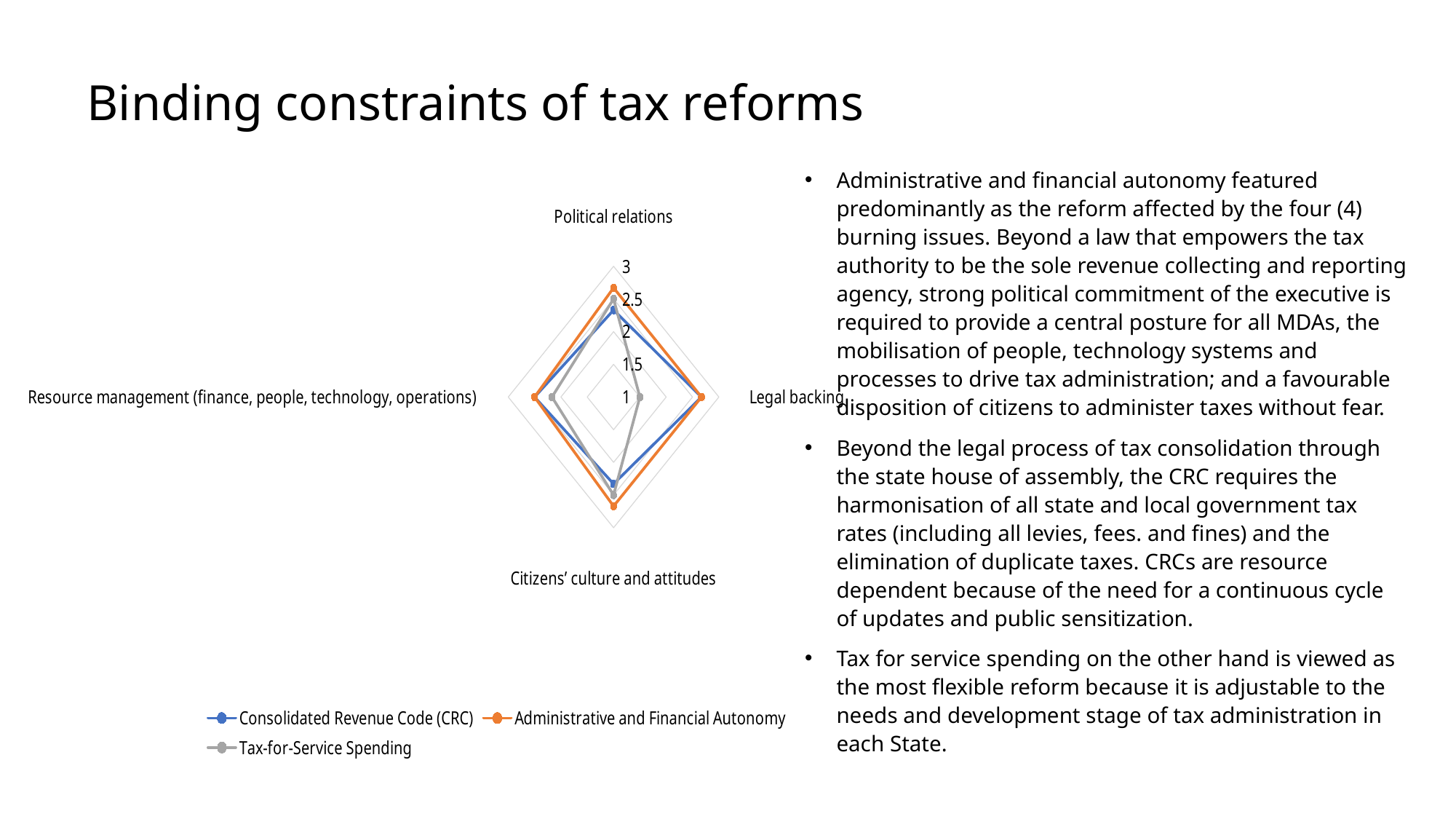
What kind of chart is shown on the slide? Radar chart How many axes (categories) does the radar chart have? 4 Is the value of Consolidated Revenue Code (CRC) on the Citizens' culture and attitudes axis greater or less than 2? greater How many series does the legend of the chart list? 3 What is the highest value shown on the chart's axis scale? 3 Is the value of Tax-for-Service Spending on the Legal backing axis greater or less than 2? less Is the value of Administrative and Financial Autonomy on the Political relations axis greater or less than 2? greater Which series has the lowest value on the Legal backing axis? Tax-for-Service Spending Which series has the highest value on the Political relations axis? Administrative and Financial Autonomy Which series is shown in gray in the chart legend? Tax-for-Service Spending Which series is shown in orange in the chart legend? Administrative and Financial Autonomy On the Legal backing axis, which is larger: Administrative and Financial Autonomy or Tax-for-Service Spending? Administrative and Financial Autonomy